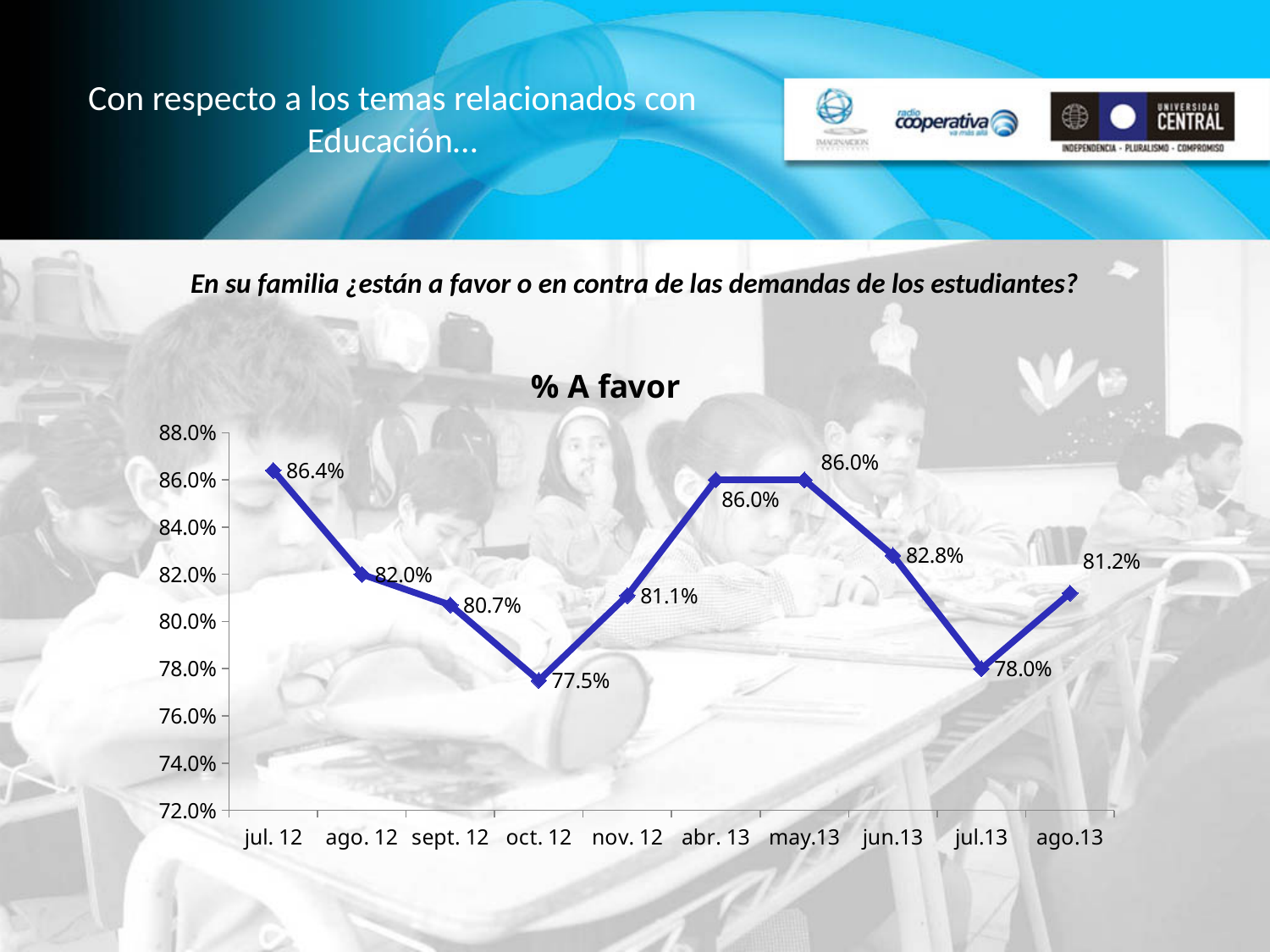
What is the difference between the values for jul. 12 and oct. 12? 8.9% Which month has the lowest value? oct. 12 How many data points are plotted on the chart? 10 What is the value for oct. 12? 77.5% What is the value for jun.13? 82.8% Which month has the highest value? jul. 12 What is the value for ago.13? 81.2% What is the value for jul. 12? 86.4% What is the title of the chart? % A favor Do the values rise or fall from jun.13 to jul.13? fall What kind of chart is shown? line chart Which is larger, the value for ago. 12 or the value for nov. 12? ago. 12